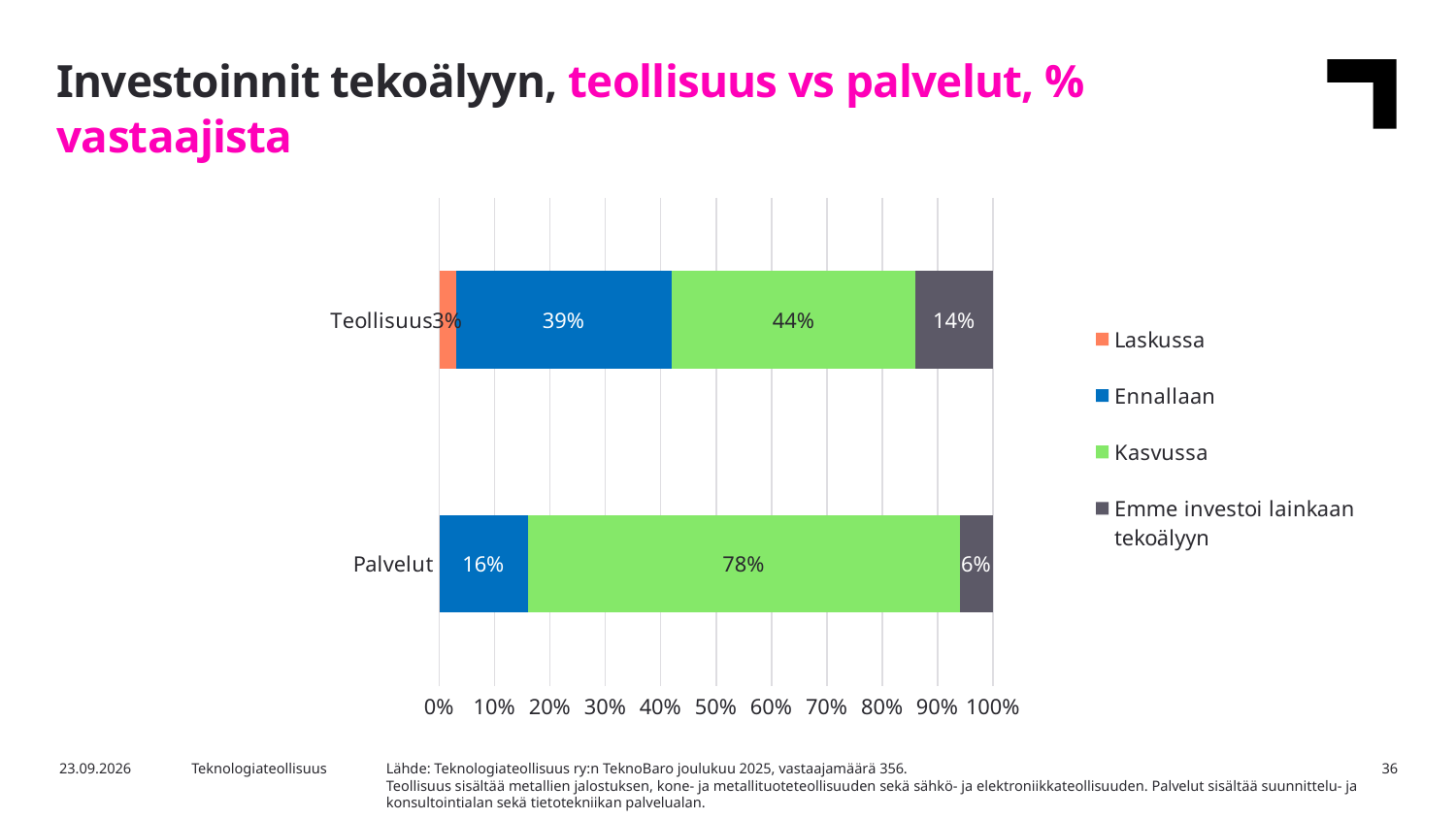
What is the difference between the Ennallaan values for Teollisuus and Palvelut? 23 percentage points What is the difference between the Kasvussa values for Palvelut and Teollisuus? 34 percentage points Which series has the largest value for Teollisuus? Kasvussa What is the Laskussa value for Teollisuus? 3% How many series does the legend list? 4 What is the 'Emme investoi lainkaan tekoälyyn' value for Palvelut? 6% What colour represents the Kasvussa series? Green What kind of chart is shown on the slide? Stacked bar chart Which category has the higher Kasvussa value, Teollisuus or Palvelut? Palvelut What is the Kasvussa value for Palvelut? 78% How many categories are shown on the vertical axis? 2 What is the Ennallaan value for Teollisuus? 39%